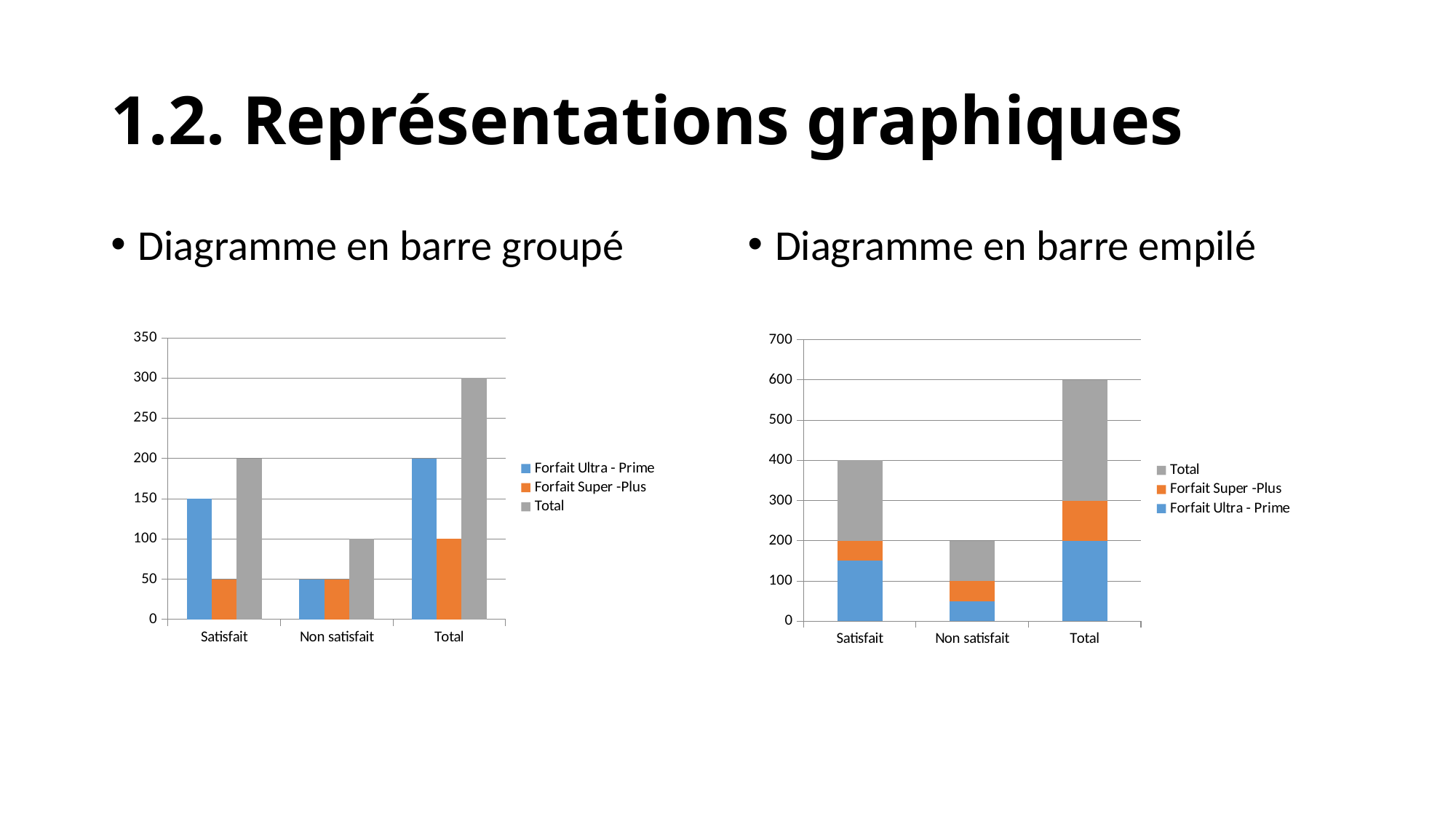
In the left chart (Diagramme en barre groupé), what is the value of Forfait Ultra - Prime for Satisfait? 150 In the left chart (Diagramme en barre groupé), which is larger for Non satisfait: Forfait Ultra - Prime or Total? Total In the left chart (Diagramme en barre groupé), what is the difference between Forfait Ultra - Prime and Forfait Super -Plus for Satisfait? 100 In the right chart (Diagramme en barre empilé), what is the total height of the stacked bar for Satisfait? 400 In the right chart (Diagramme en barre empilé), how many categories are shown on the x axis? 3 In the left chart (Diagramme en barre groupé), what is the value of Forfait Super -Plus for Total? 100 In the right chart (Diagramme en barre empilé), which category has the lowest stacked bar? Non satisfait In the right chart (Diagramme en barre empilé), what is the total height of the stacked bar for Total? 600 What kind of chart is the right chart (Diagramme en barre empilé)? Stacked bar chart In the left chart (Diagramme en barre groupé), which category has the highest Total bar? Total In the left chart (Diagramme en barre groupé), what is the value of Total for Non satisfait? 100 In the left chart (Diagramme en barre groupé), how many series does the legend list? 3